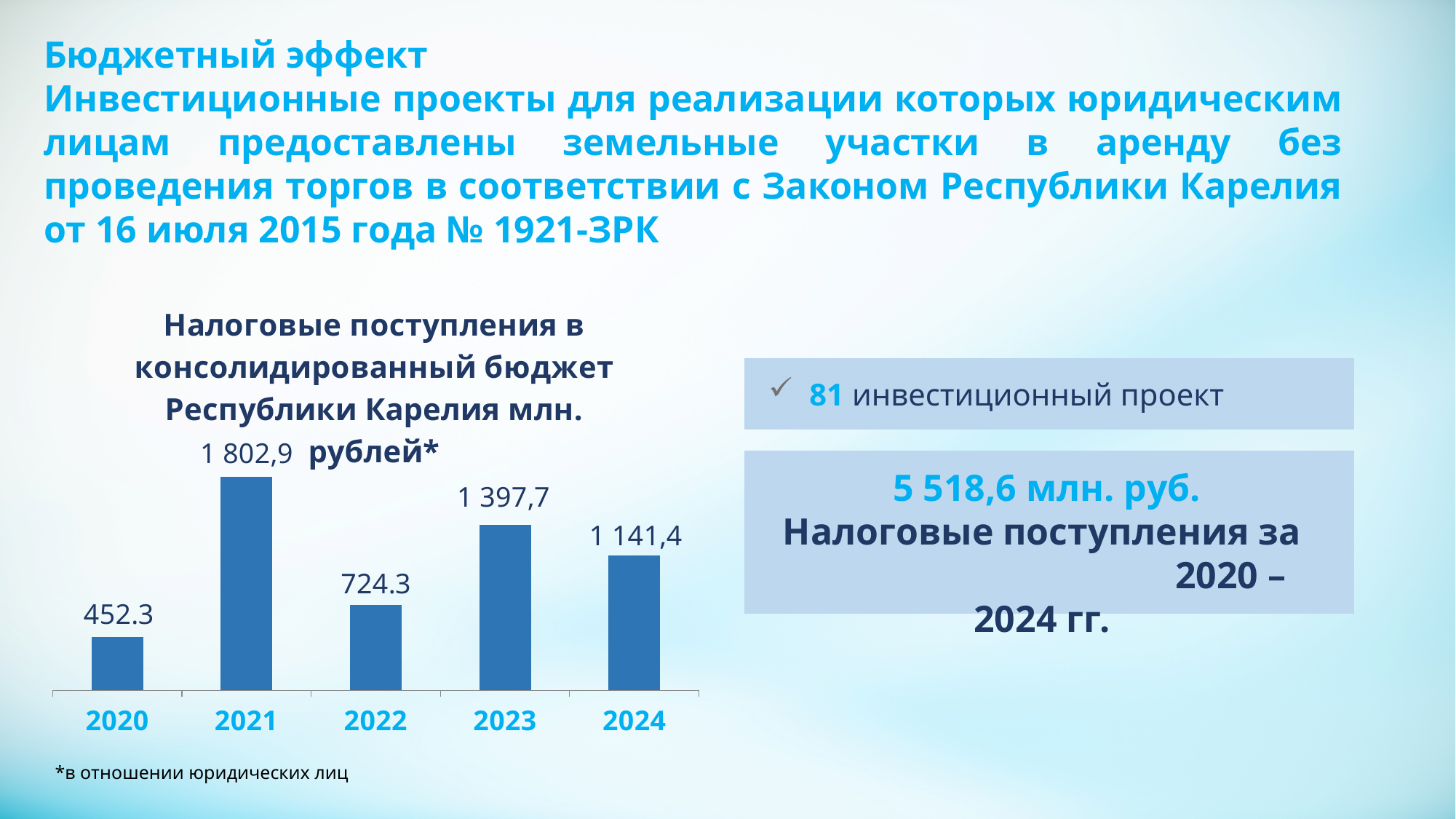
Which year has the highest value in the chart? 2021 How many years are shown on the x axis of the chart? 5 Which year has the lowest value in the chart? 2020 Which is larger, the value for 2022 or the value for 2024? 2024 What is the value for 2023 in the chart? 1 397,7 What is the value for 2021 in the chart? 1 802,9 What is the value for 2024 in the chart? 1 141,4 What is the difference between the values for 2021 and 2023? 405,2 What type of chart is shown on the slide? bar chart What is the difference between the values for 2023 and 2024? 256,3 What is the value for 2020 in the chart? 452.3 Do the values rise or fall from 2023 to 2024? fall